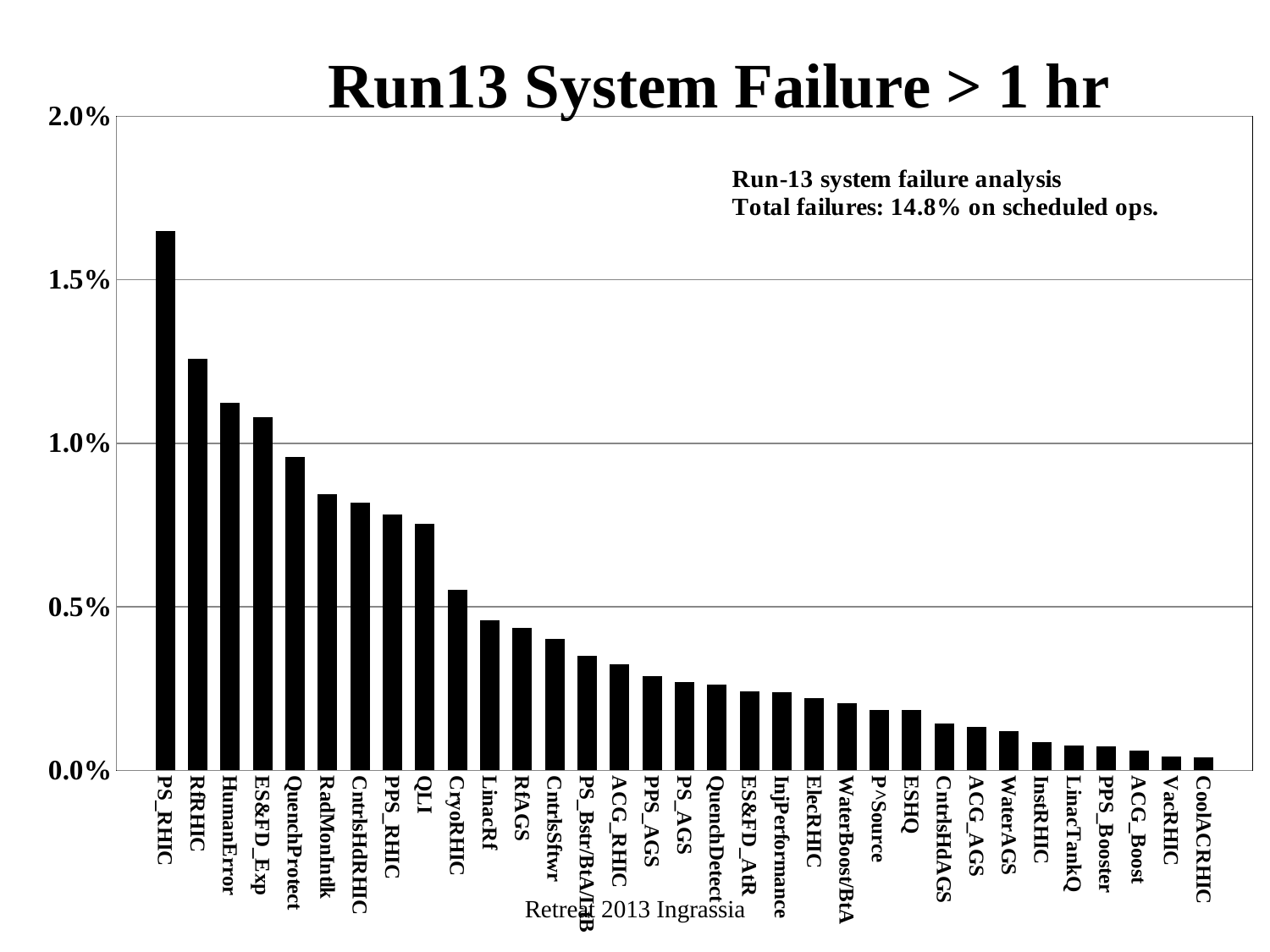
Do the bar values rise or fall from left to right along the x axis? Fall Is the value for QuenchProtect greater or less than 1.0%? less Which system has the highest failure percentage? PS_RHIC How many systems (bars) are shown on the chart? 33 What kind of chart is shown on the slide? Bar chart According to the annotation on the chart, what is the total failure percentage on scheduled ops? 14.8% Is the value for RfAGS greater or less than 0.5%? less Is the value for RfRHIC greater or less than 1.0%? greater What is the title of the chart? Run13 System Failure > 1 hr Which has the larger value, QLI or CryoRHIC? QLI